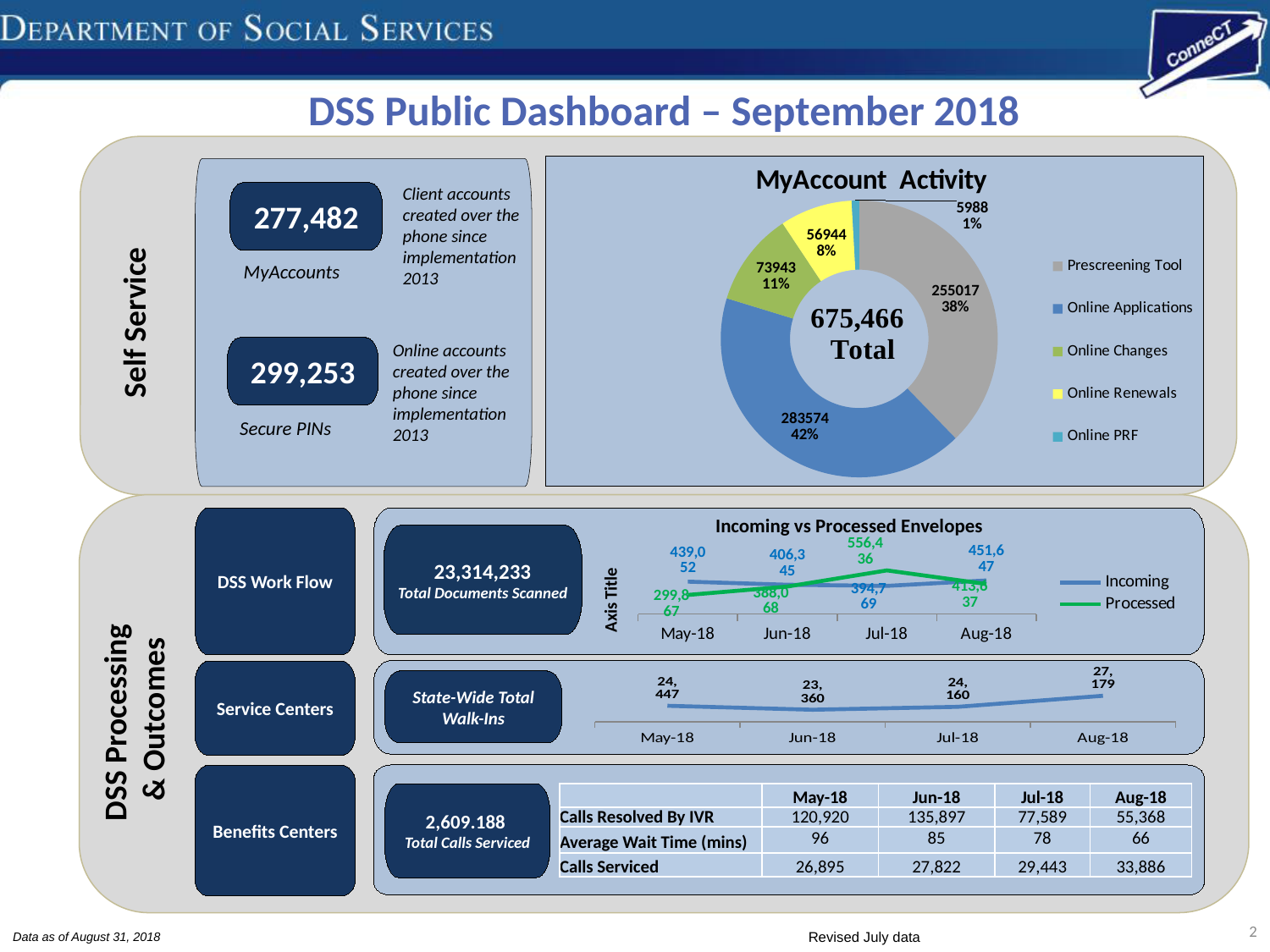
How many categories does the legend of the MyAccount Activity chart list? 5 How many series does the legend of the Incoming vs Processed Envelopes chart list? 2 What type of chart is the MyAccount Activity chart? doughnut chart In the State-Wide Total Walk-Ins chart, what is the value for Aug-18? 27,179 In the MyAccount Activity chart, which category has the largest value? Online Applications In the State-Wide Total Walk-Ins chart, which month has the lowest value? Jun-18 In the MyAccount Activity chart, what is the difference between Online Changes and Online Renewals? 16999 In the Incoming vs Processed Envelopes chart, which month has the highest Incoming value? Aug-18 In the MyAccount Activity chart, what is the value for Online Applications? 283574 What total is printed in the center of the MyAccount Activity chart? 675,466 In the MyAccount Activity chart, what percentage share does the Prescreening Tool slice have? 38% In the MyAccount Activity chart, which category has the smallest value? Online PRF